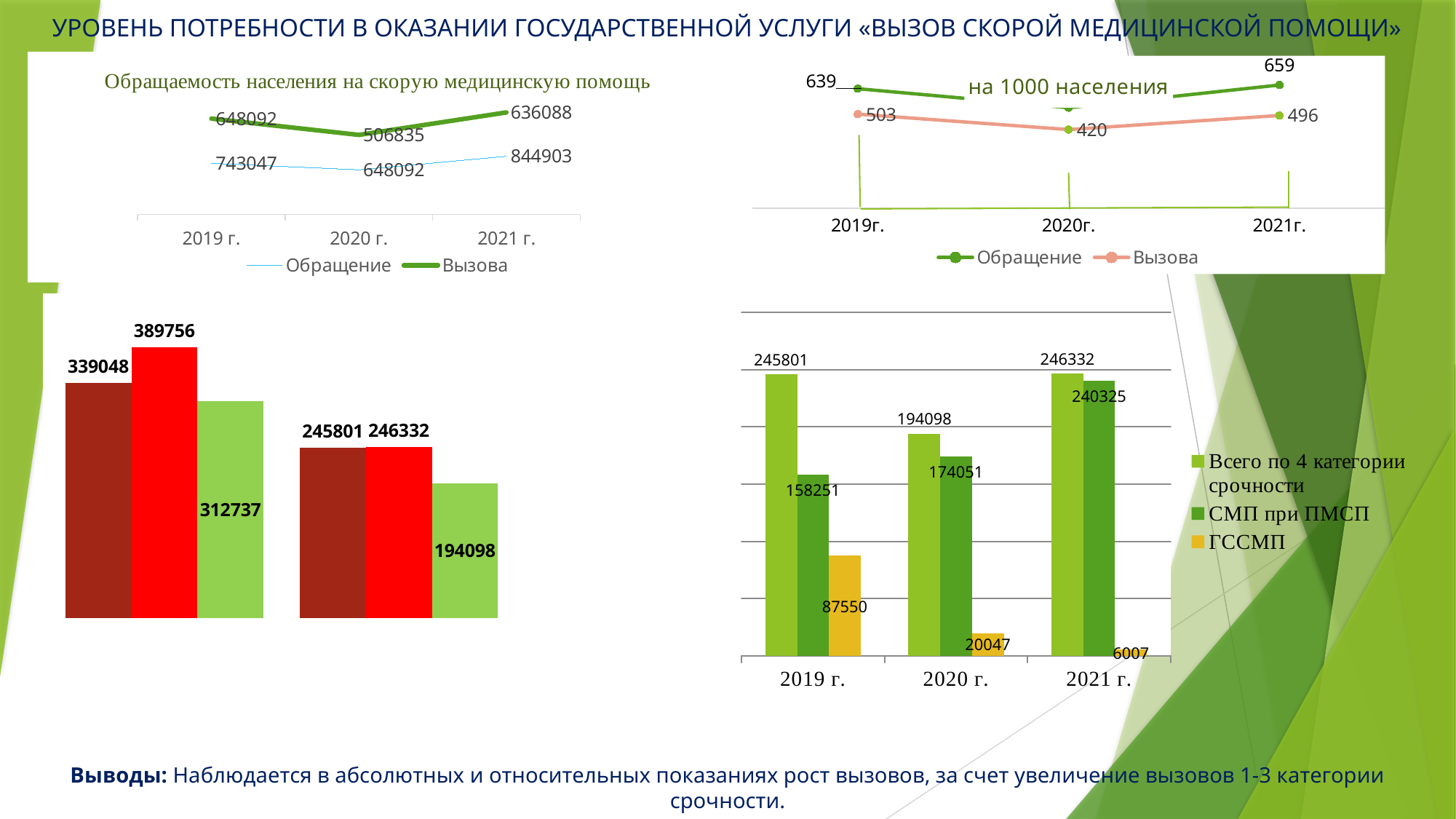
In the bottom-right bar chart, how many series does the legend list? 3 In the bottom-left bar chart, what is the highest value shown? 389756 In the bottom-right bar chart, which year has the lowest value for ГССМП? 2021 г. In the bottom-right bar chart, what is the value for ГССМП in 2019 г.? 87550 In the top-right chart titled 'на 1000 населения', what is the value for Обращение in 2021г.? 659 In the top-right chart titled 'на 1000 населения', what is the value for Вызова in 2020г.? 420 What kind of chart is the top-left chart 'Обращаемость населения на скорую медицинскую помощь'? line chart In the top-right chart titled 'на 1000 населения', which is larger in 2019г., Обращение or Вызова? Обращение In the top-left chart 'Обращаемость населения на скорую медицинскую помощь', what is the value labelled for Вызова in 2020 г.? 506835 In the bottom-right bar chart, does the value for ГССМП rise or fall from 2019 г. to 2021 г.? fall In the bottom-right bar chart, what is the difference between Всего по 4 категории срочности and СМП при ПМСП in 2020 г.? 20047 In the bottom-right bar chart, what is the value for СМП при ПМСП in 2021 г.? 240325